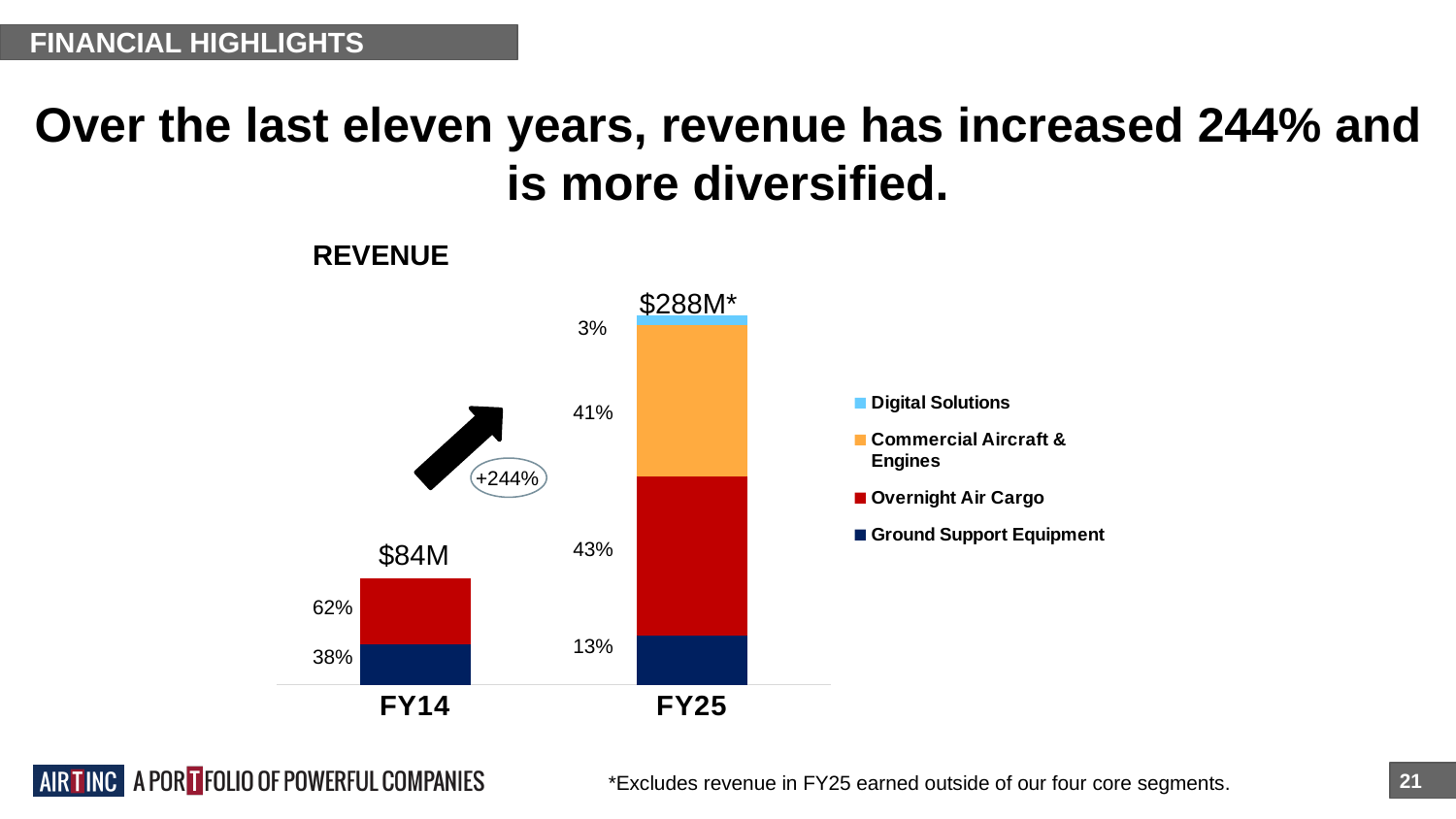
Which segment has the largest share of FY25 revenue? Overnight Air Cargo Which segment has the smallest share of FY25 revenue? Digital Solutions How many fiscal years are shown on the x axis? 2 By how many percentage points did the Ground Support Equipment share fall from FY14 to FY25? 25 percentage points What percentage of FY25 revenue came from Digital Solutions? 3% How many series does the legend list? 4 What percentage of FY14 revenue came from Ground Support Equipment? 38% What is the total revenue shown for FY25? $288M* What percentage of FY14 revenue came from Overnight Air Cargo? 62% What is the total revenue shown for FY14? $84M What percentage of FY25 revenue came from Commercial Aircraft & Engines? 41% What kind of chart is shown under the title REVENUE? Stacked bar chart